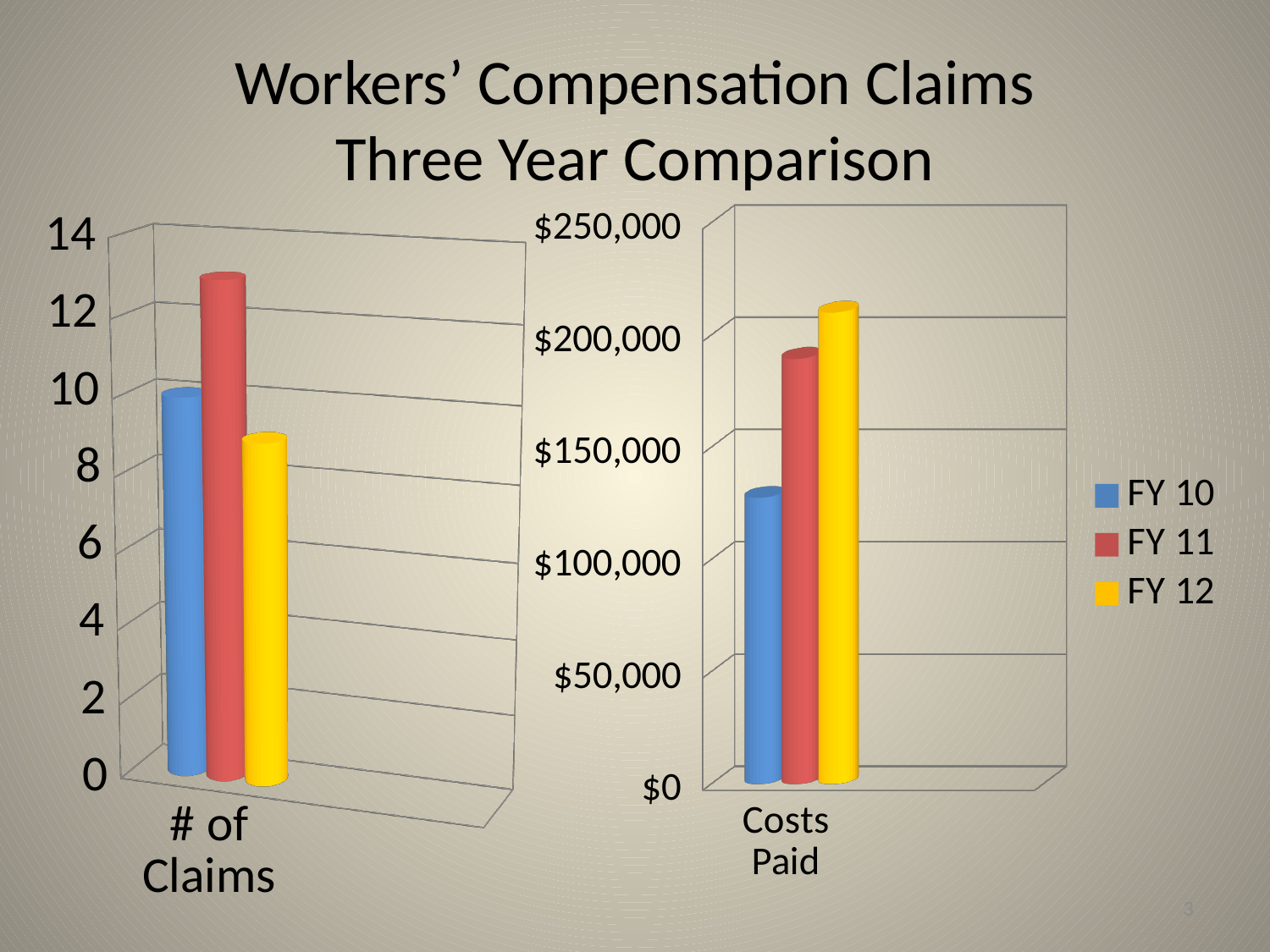
In the "Costs Paid" chart, which fiscal year has the highest costs paid? FY 12 How many series does the legend list on the slide? 3 In the "# of Claims" chart, which fiscal year has the lowest number of claims? FY 12 In the "# of Claims" chart, which fiscal year has the highest number of claims? FY 11 In the "# of Claims" chart, is the value for FY 12 greater or less than 10? less In the "# of Claims" chart, is the value for FY 11 greater or less than 12? greater In the "Costs Paid" chart, is the value for FY 10 greater or less than $150,000? less In the "Costs Paid" chart, which fiscal year has the lowest costs paid? FY 10 In the "Costs Paid" chart, which is larger, the value for FY 11 or the value for FY 10? FY 11 What kind of chart is the left chart, labelled "# of Claims"? Bar chart What is the title shown at the top of the slide? Workers' Compensation Claims Three Year Comparison